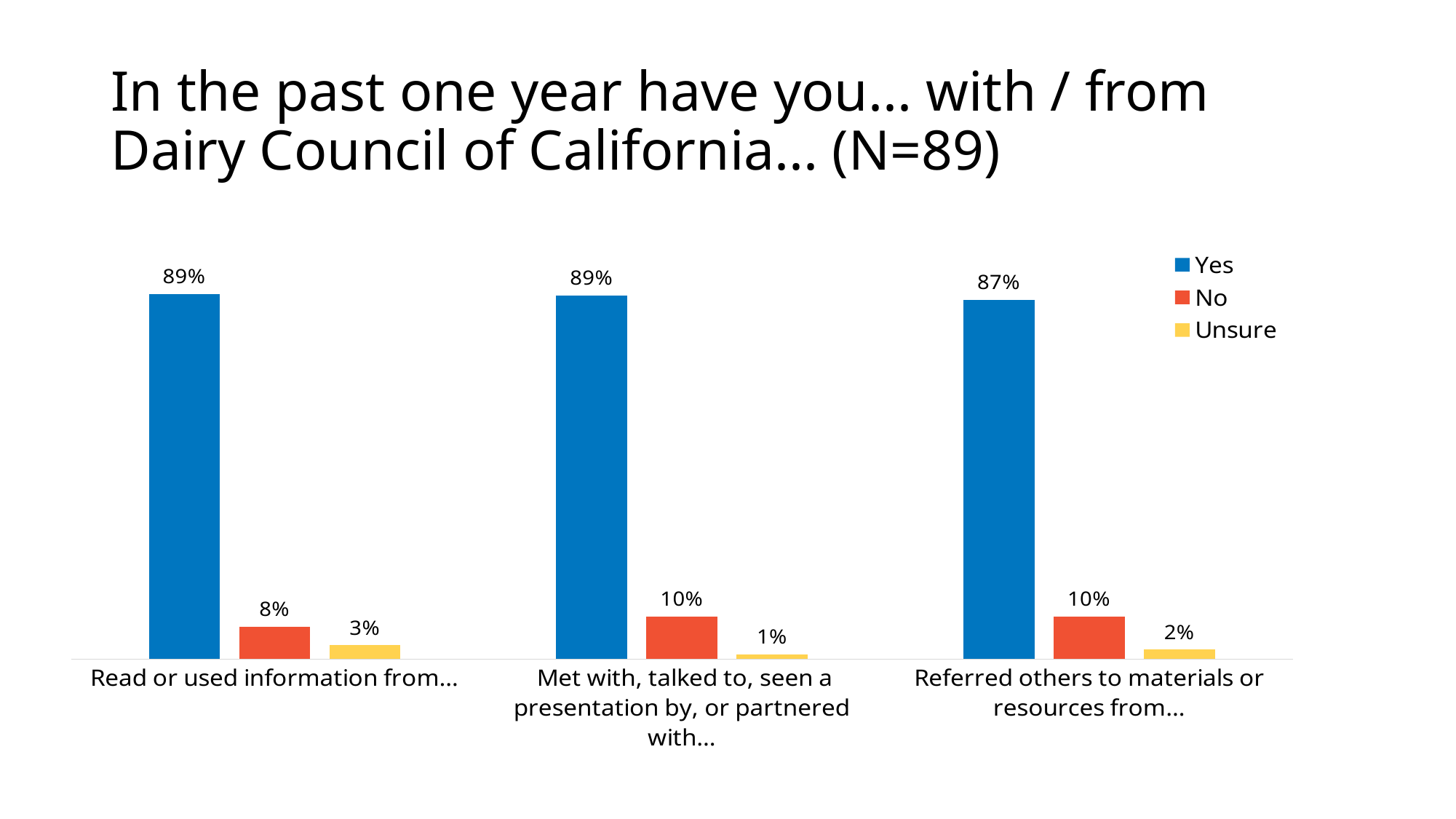
How many series does the legend list? 3 Which category has the lowest Unsure value? Met with, talked to, seen a presentation by, or partnered with... What percentage answered Yes for "Read or used information from..."? 89% How many categories are shown on the x axis? 3 Which category has the lowest Yes value? Referred others to materials or resources from... Which colour represents the Unsure series in the legend? Yellow What percentage answered No for "Met with, talked to, seen a presentation by, or partnered with..."? 10% What percentage answered Unsure for "Referred others to materials or resources from..."? 2% What is the difference between the Yes and No values for "Read or used information from..."? 81% What percentage answered Yes for "Referred others to materials or resources from..."? 87% Which is larger: the No value for "Read or used information from..." or the No value for "Referred others to materials or resources from..."? Referred others to materials or resources from... What kind of chart is shown on the slide? Bar chart